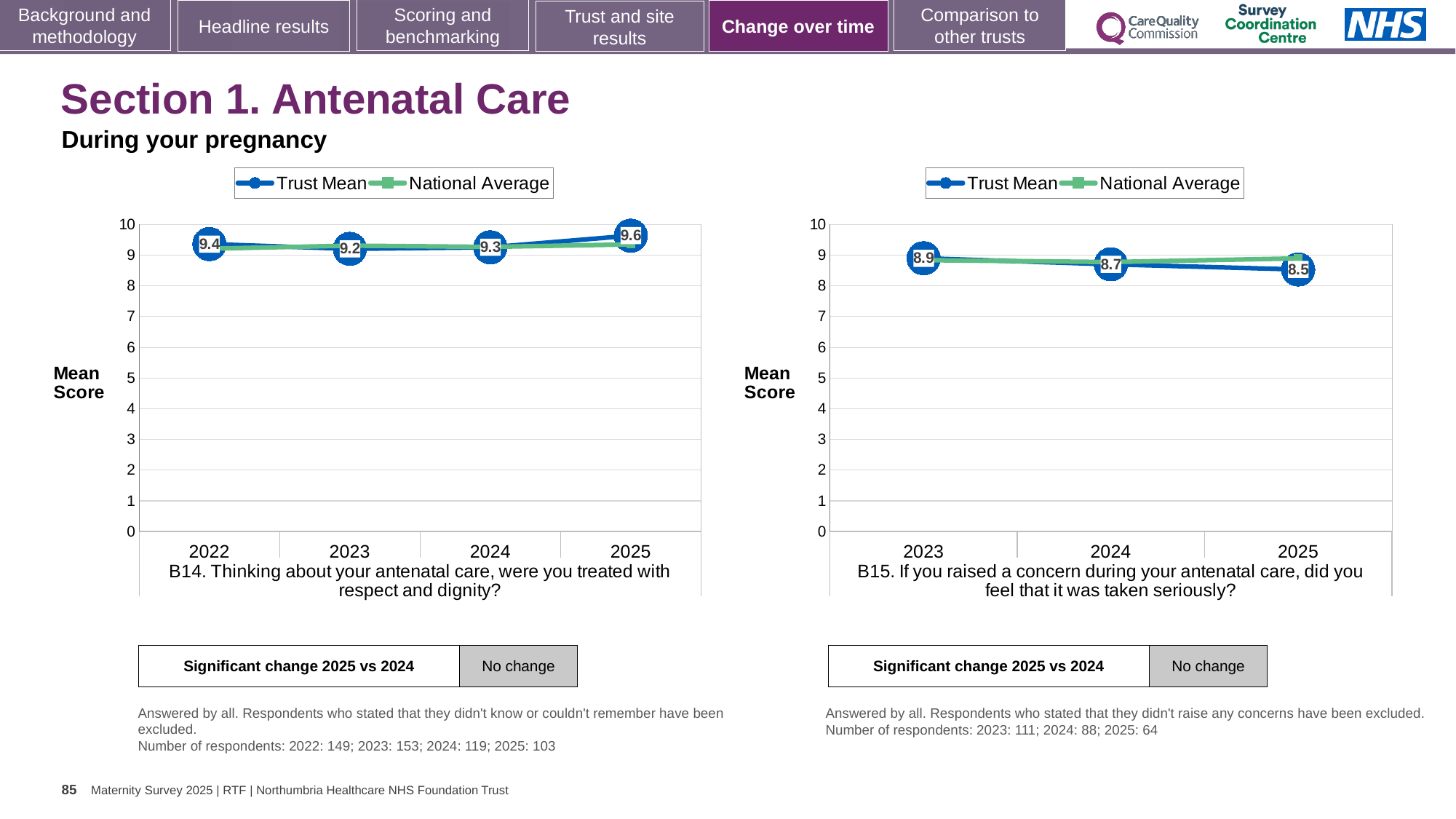
In the B14 chart (left), what is the Trust Mean score for 2025? 9.6 What kind of chart is the B14 chart (left)? line chart In the B15 chart (right), what is the difference between the Trust Mean scores for 2023 and 2025? 0.4 How many years are shown on the x axis of the B14 chart (left)? 4 In the B15 chart (right), does the Trust Mean score rise or fall from 2023 to 2025? fall In the B14 chart (left), which year has the highest Trust Mean score? 2025 In the B15 chart (right), what is the Trust Mean score for 2024? 8.7 In the B15 chart (right), which year has the lowest Trust Mean score? 2025 In the B14 chart (left), what is the difference between the Trust Mean scores for 2025 and 2023? 0.4 How many series does the legend of the B15 chart (right) list? 2 In the B15 chart (right), is the Trust Mean score higher in 2023 or in 2025? 2023 In the B14 chart (left), what is the Trust Mean score for 2023? 9.2